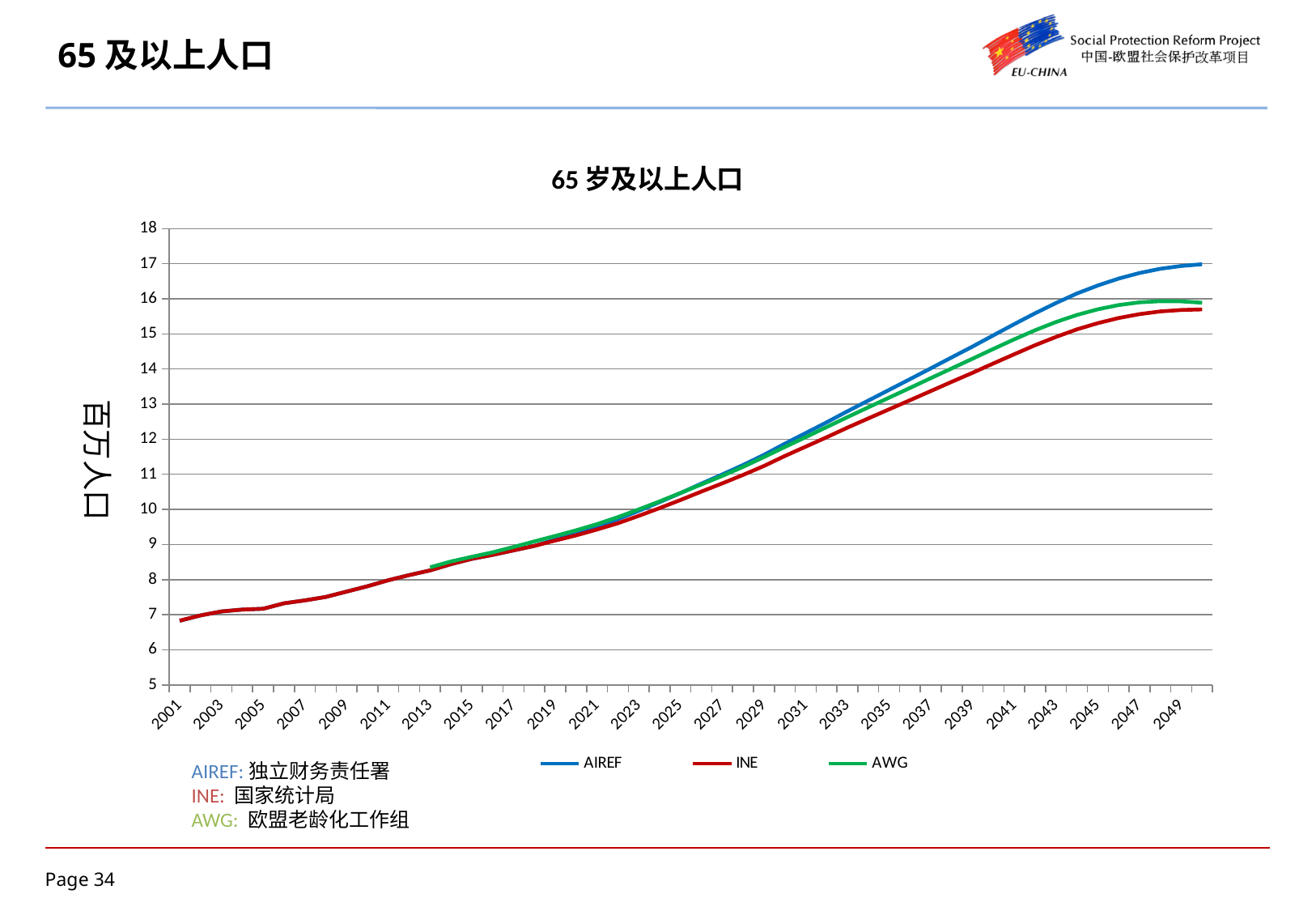
How many series does the legend list? 3 Is the INE value at 2049 greater or less than 16? less Do the values rise or fall from 2001 to 2049? rise Is the INE value for 2031 greater or less than 12? less What kind of chart is shown on the slide? line chart What is the label on the vertical axis? 百万人口 Which series is lowest at the right end of the chart (around 2049)? INE What is the title of the chart? 65 岁及以上人口 Which series is highest at the right end of the chart (around 2049)? AIREF Is the value for 2001 greater or less than 7? less At 2049, is the AIREF value larger or smaller than the INE value? larger